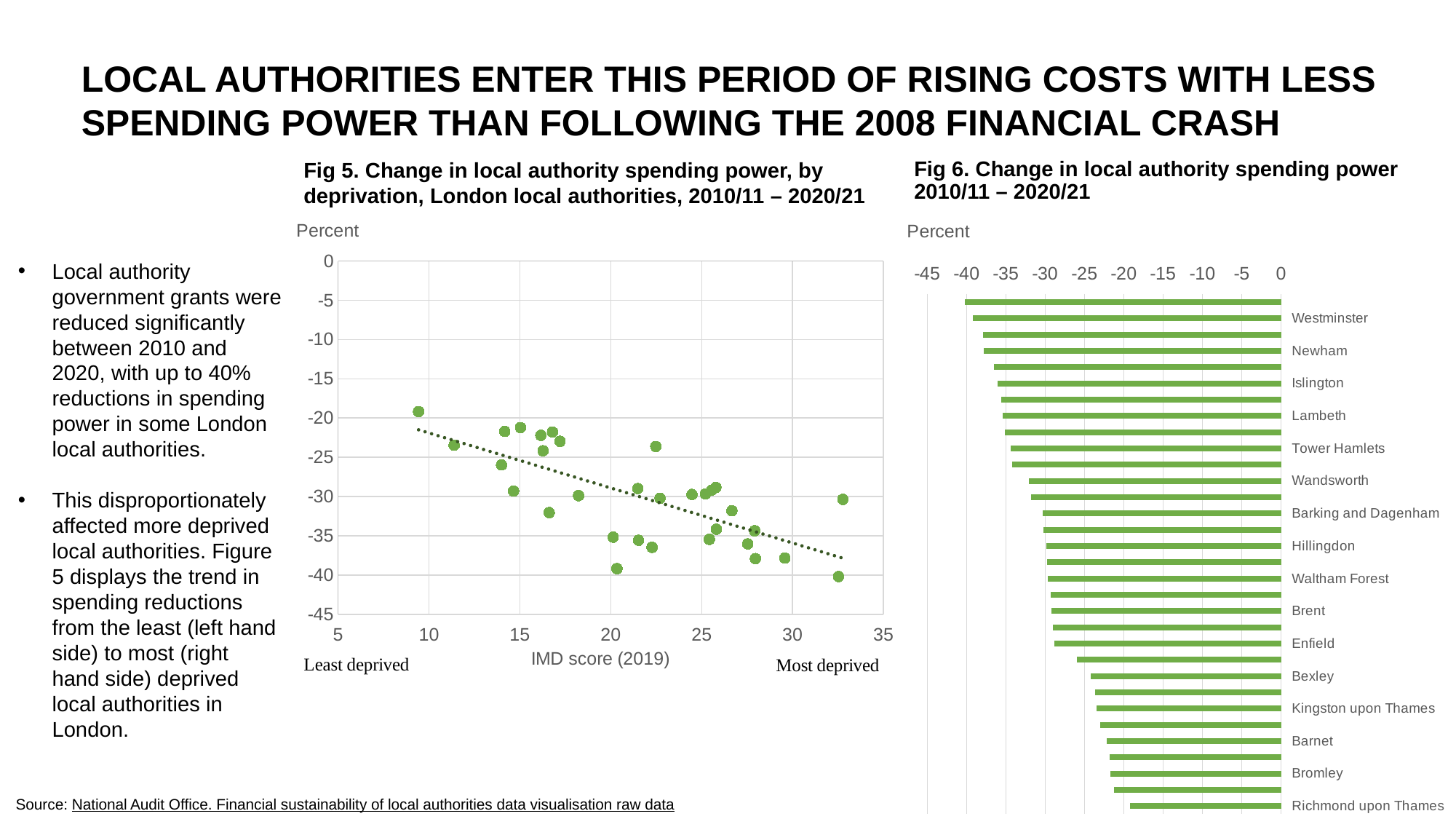
In Fig 6, which local authority has the smallest reduction in spending power (the shortest bar)? Richmond upon Thames In Fig 6, is the value for Bromley greater or less than -30? greater What kind of chart is Fig 6? Bar chart How many bars are plotted in Fig 6? 32 What kind of chart is Fig 5? Scatter plot What is the label of the x axis in Fig 5? IMD score (2019) In Fig 6, is the value for Richmond upon Thames greater or less than -25? greater In Fig 6, which has the larger reduction in spending power, Westminster or Richmond upon Thames? Westminster In Fig 6, which has the larger reduction in spending power, Newham or Bexley? Newham In Fig 6, is the value for Westminster greater or less than -35? less In Fig 5, does the change in spending power rise or fall as the IMD score increases along the x axis? Fall